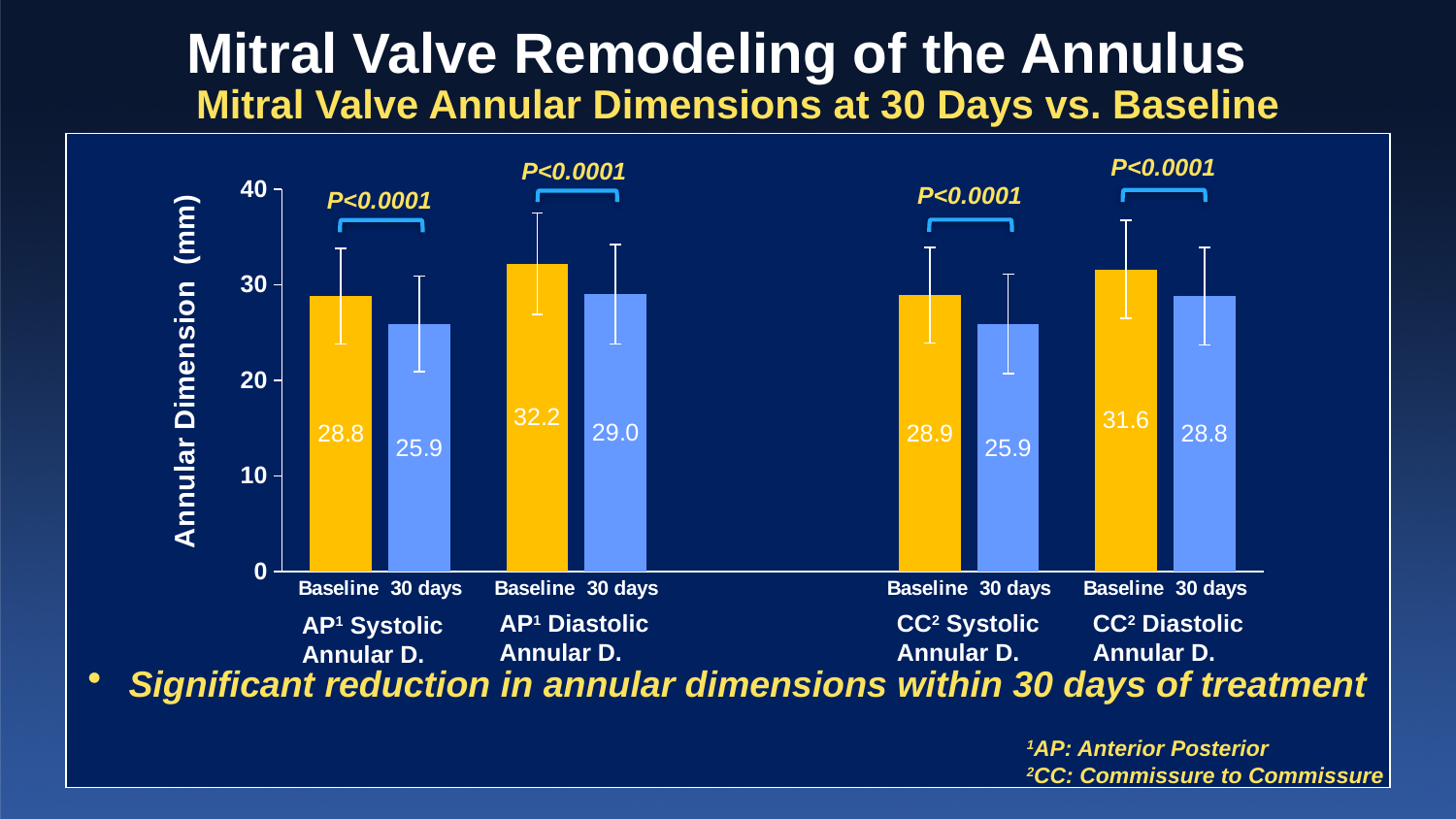
What is the baseline value for CC Diastolic Annular D.? 31.6 Which is larger, the baseline value for AP Systolic Annular D. or the baseline value for CC Diastolic Annular D.? CC Diastolic Annular D. baseline Is the baseline value for AP Diastolic Annular D. greater or less than 30? greater What is the label of the y axis? Annular Dimension (mm) What is the difference between the baseline and 30 days values for CC Diastolic Annular D.? 2.8 What is the 30 days value for CC Systolic Annular D.? 25.9 Which bar has the highest value on the chart? AP Diastolic Annular D. Baseline (32.2) What kind of chart is shown on the slide? Bar chart What is the baseline value for AP Systolic Annular D.? 28.8 How many bars are plotted on the chart? 8 What is the 30 days value for AP Diastolic Annular D.? 29.0 What is the difference between the baseline and 30 days values for AP Diastolic Annular D.? 3.2